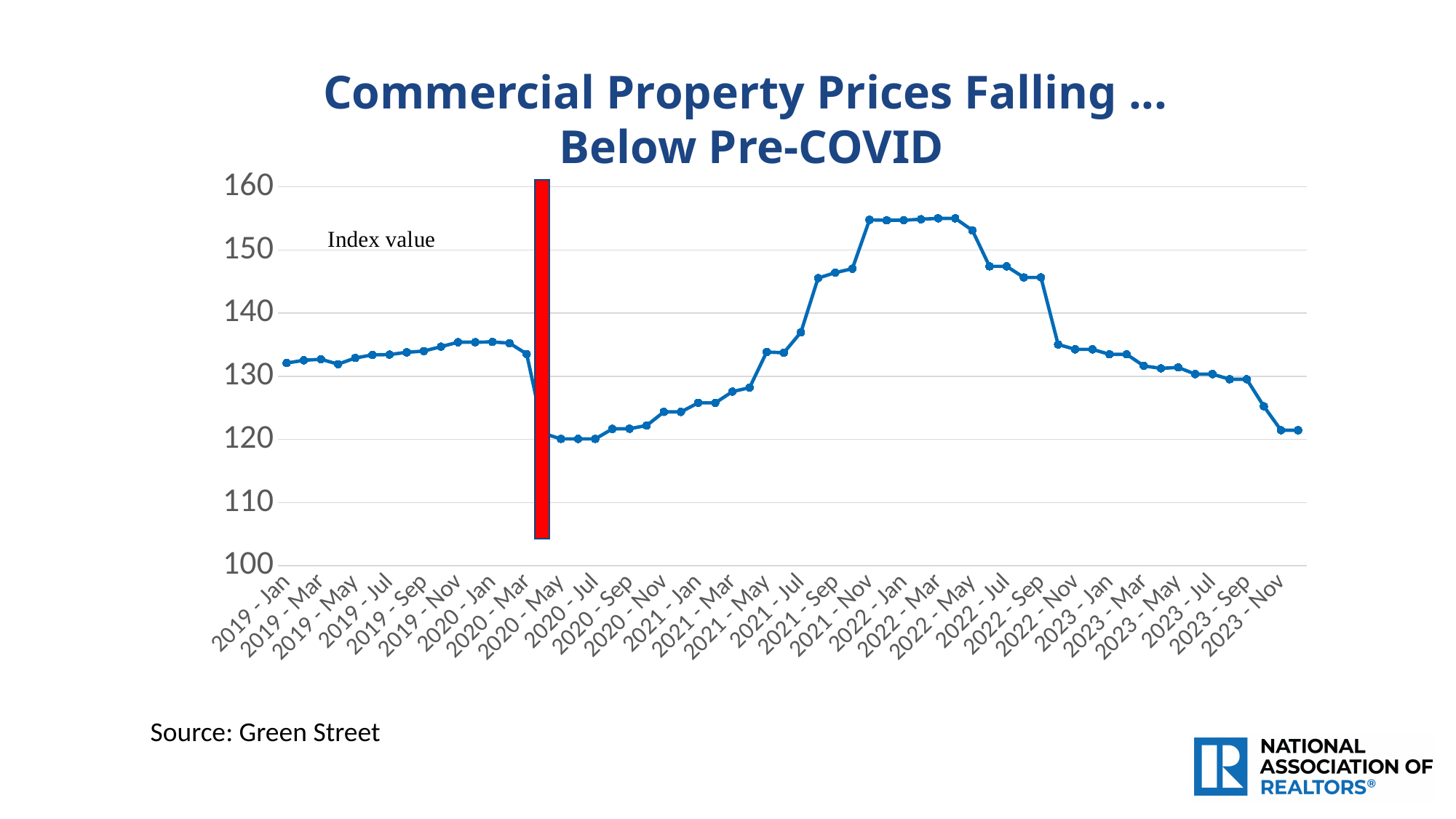
What is the source cited for the chart? Green Street Which is larger, the value for 2019 - Jan or the value for 2023 - Nov? 2019 - Jan Does the line rise or fall between 2020 - May and 2021 - Nov? Rise What kind of chart is shown on the slide? Line chart Does the line rise or fall between 2022 - Mar and 2023 - Nov? Fall Is the value for 2021 - Sep greater or less than 140? greater Is the value for 2022 - Jan greater or less than 150? greater Is the value for 2023 - Nov greater or less than 130? less What is the title of the chart? Commercial Property Prices Falling … Below Pre-COVID